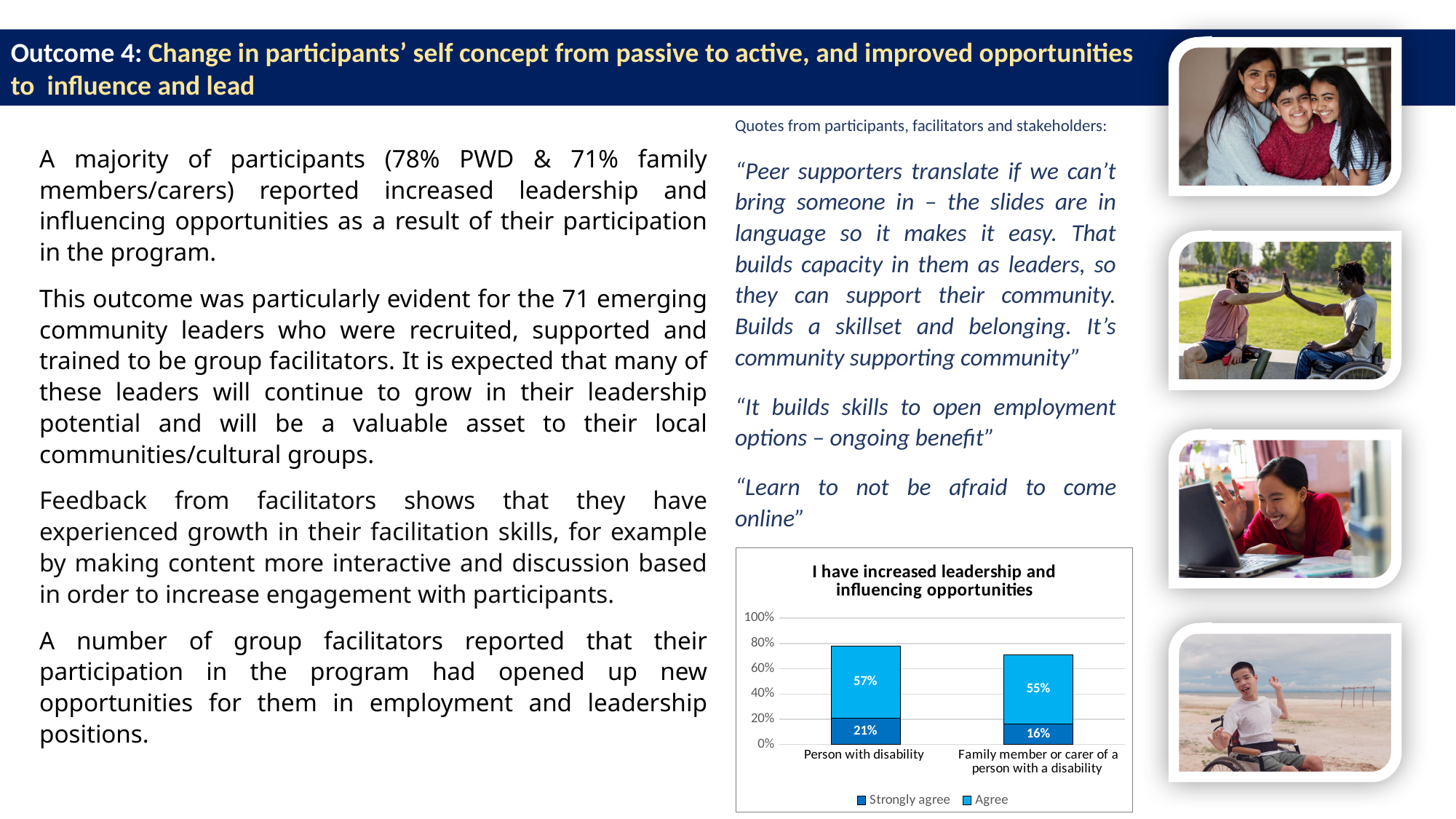
How many series does the legend list? 2 What is the difference between the 'Strongly agree' values for Person with disability and Family member or carer of a person with a disability? 5% What is the total of the stacked bar for Person with disability? 78% What is the total of the stacked bar for Family member or carer of a person with a disability? 71% Which category has the higher 'Strongly agree' value? Person with disability What is the title of the chart? I have increased leadership and influencing opportunities How many categories are shown on the x axis? 2 What is the 'Strongly agree' value for Family member or carer of a person with a disability? 16% What is the 'Strongly agree' value for Person with disability? 21% What kind of chart is shown on the slide? stacked bar chart What is the 'Agree' value for Person with disability? 57% What is the 'Agree' value for Family member or carer of a person with a disability? 55%